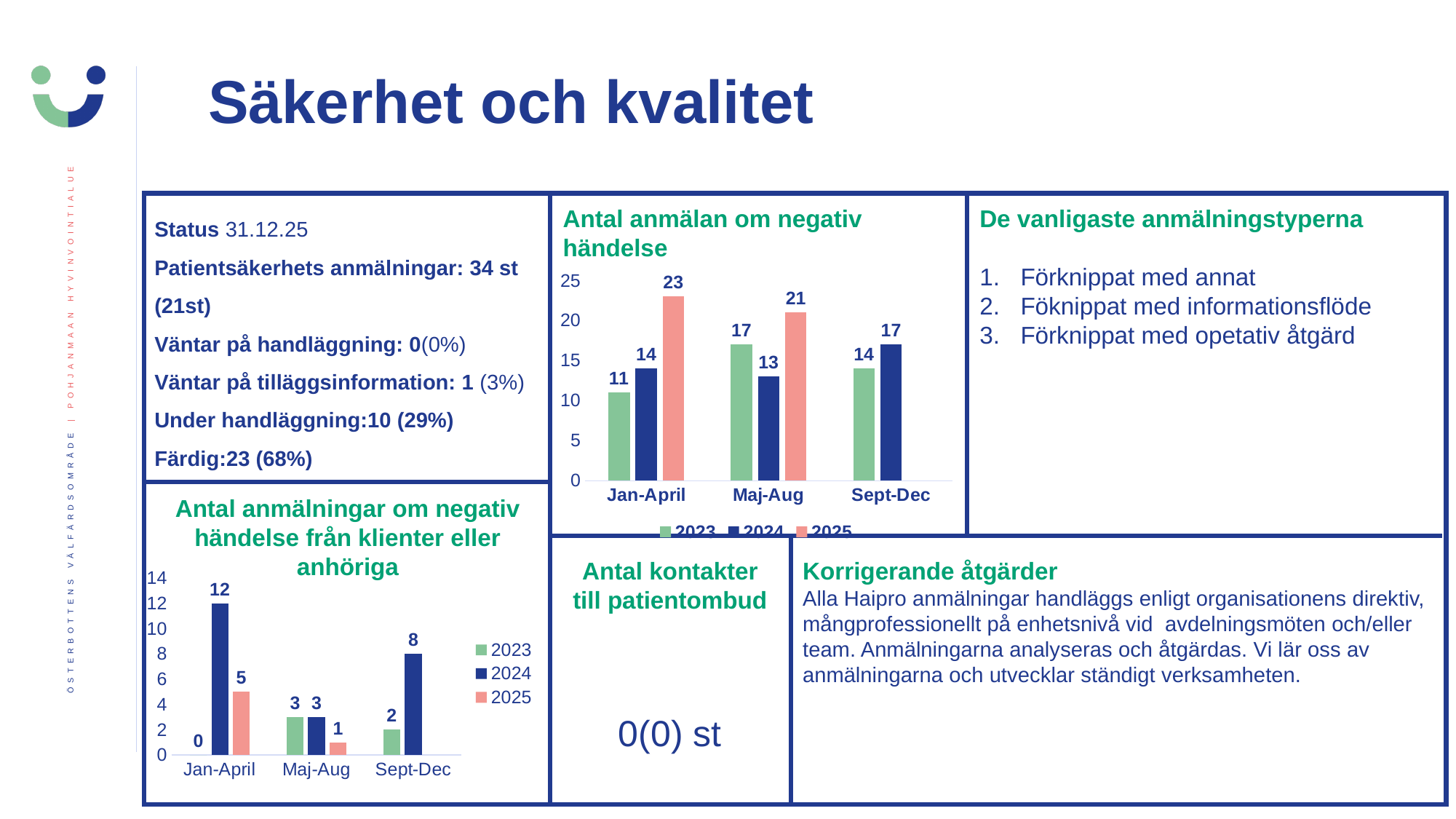
In the chart 'Antal anmälningar om negativ händelse från klienter eller anhöriga', what is the value for 2025 in Maj-Aug? 1 In the chart 'Antal anmälan om negativ händelse', which is larger in Maj-Aug: the 2024 value or the 2025 value? 2025 In the chart 'Antal anmälan om negativ händelse', what is the value for 2025 in Jan-April? 23 In the chart 'Antal anmälningar om negativ händelse från klienter eller anhöriga', what is the value for 2024 in Jan-April? 12 In the chart 'Antal anmälningar om negativ händelse från klienter eller anhöriga', what is the difference between the 2024 and 2023 values in Sept-Dec? 6 In the chart 'Antal anmälningar om negativ händelse från klienter eller anhöriga', which period has the lowest value for 2023? Jan-April In the chart 'Antal anmälan om negativ händelse', which period has the highest value for 2024? Sept-Dec How many periods are shown on the x axis of the chart 'Antal anmälningar om negativ händelse från klienter eller anhöriga'? 3 In the chart 'Antal anmälan om negativ händelse', what is the value for 2023 in Maj-Aug? 17 In the chart 'Antal anmälan om negativ händelse', what is the difference between the 2025 and 2023 values in Jan-April? 12 What kind of chart is 'Antal anmälan om negativ händelse'? Bar chart In the chart 'Antal anmälan om negativ händelse', how many series does the legend list? 3